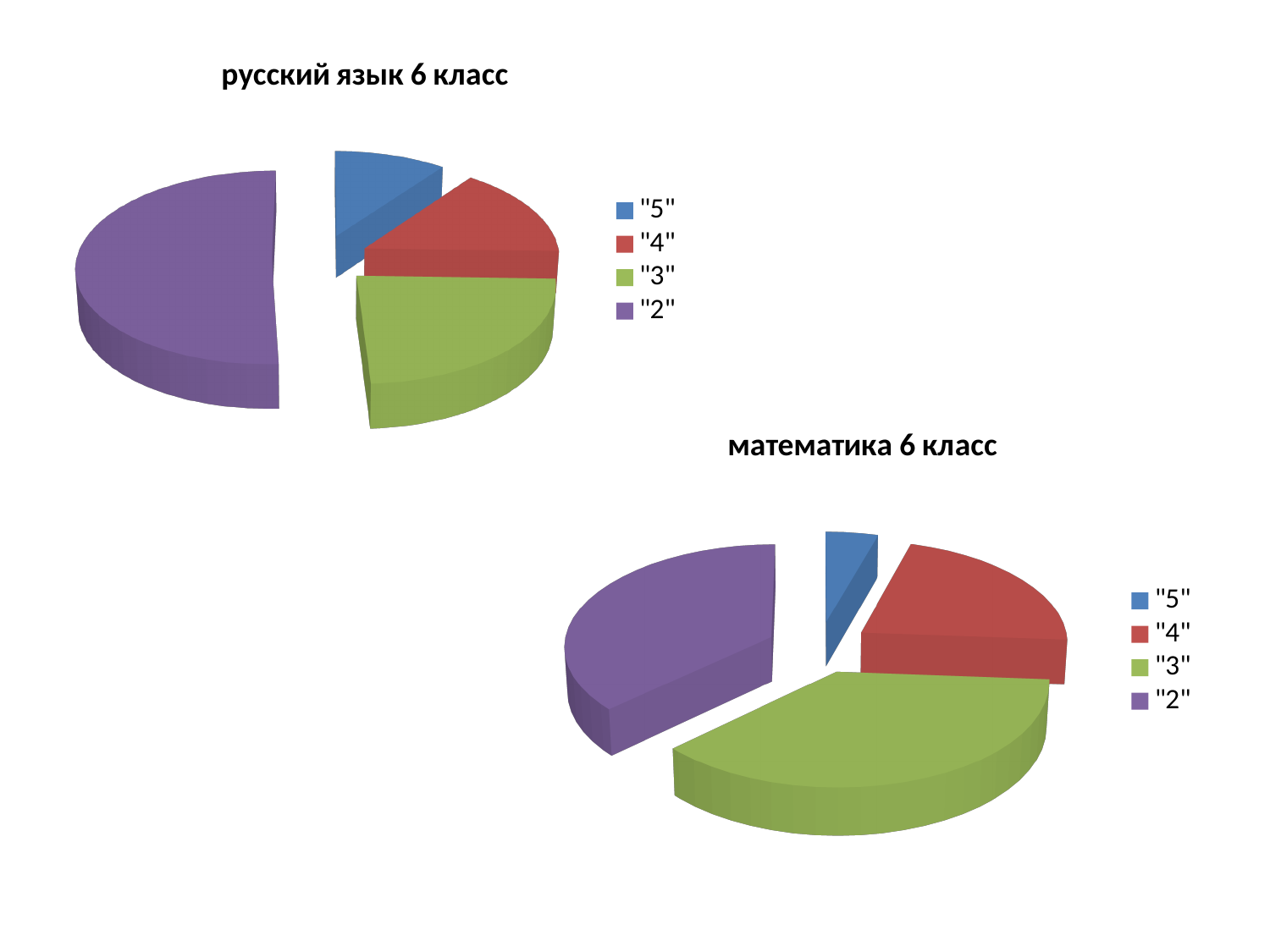
In the "математика 6 класс" chart, which category has the smallest slice? "5" What type of chart is the "математика 6 класс" chart? pie chart How many slices does the "русский язык 6 класс" pie chart have? 4 In the "русский язык 6 класс" chart, which category has the smallest slice? "5" How many entries does the legend of the "математика 6 класс" chart list? 4 What is the title of the lower pie chart on the slide? математика 6 класс In the "русский язык 6 класс" chart, which slice is larger, "3" or "4"? "3" What colour represents the category "2" in both pie charts? purple In the "русский язык 6 класс" chart, which category has the largest slice? "2" What type of chart is the "русский язык 6 класс" chart? pie chart